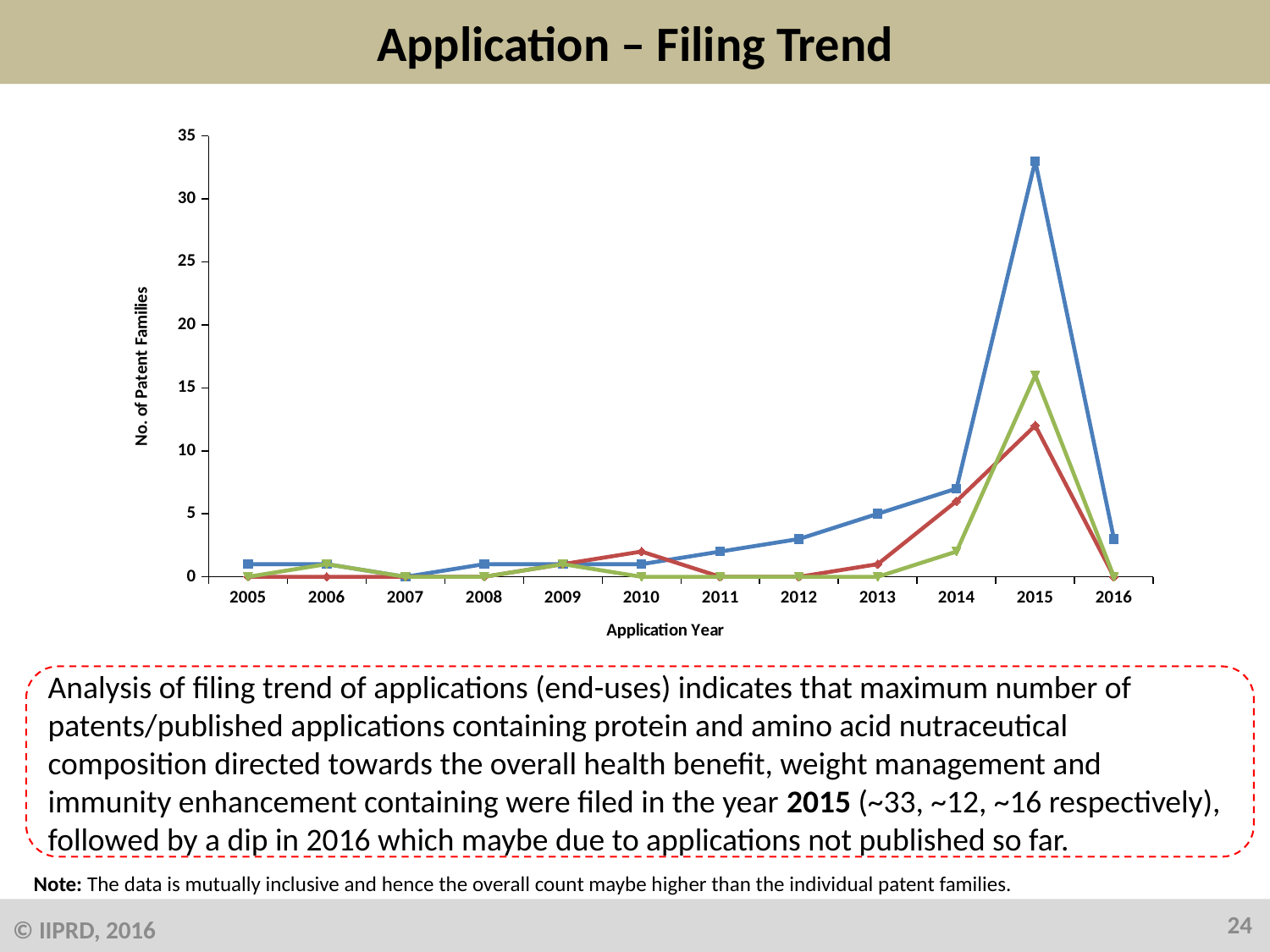
Is the value of the red line in 2015 greater or less than 15? less Is the value of the green line in 2015 greater or less than 10? greater What is the value of the red line in 2007? 0 Is the value of the blue line in 2015 greater or less than 30? greater What is the title of the y axis of the chart? No. of Patent Families In 2015, which line has the larger value, the green line or the red line? green line In which year does the blue line reach its highest value? 2015 Does the blue line rise or fall from 2015 to 2016? fall How many application years are shown on the x axis of the chart? 12 In 2015, which line has the larger value, the blue line or the green line? blue line What is the value of the blue line in 2013? 5 What kind of chart is shown on the slide? line chart